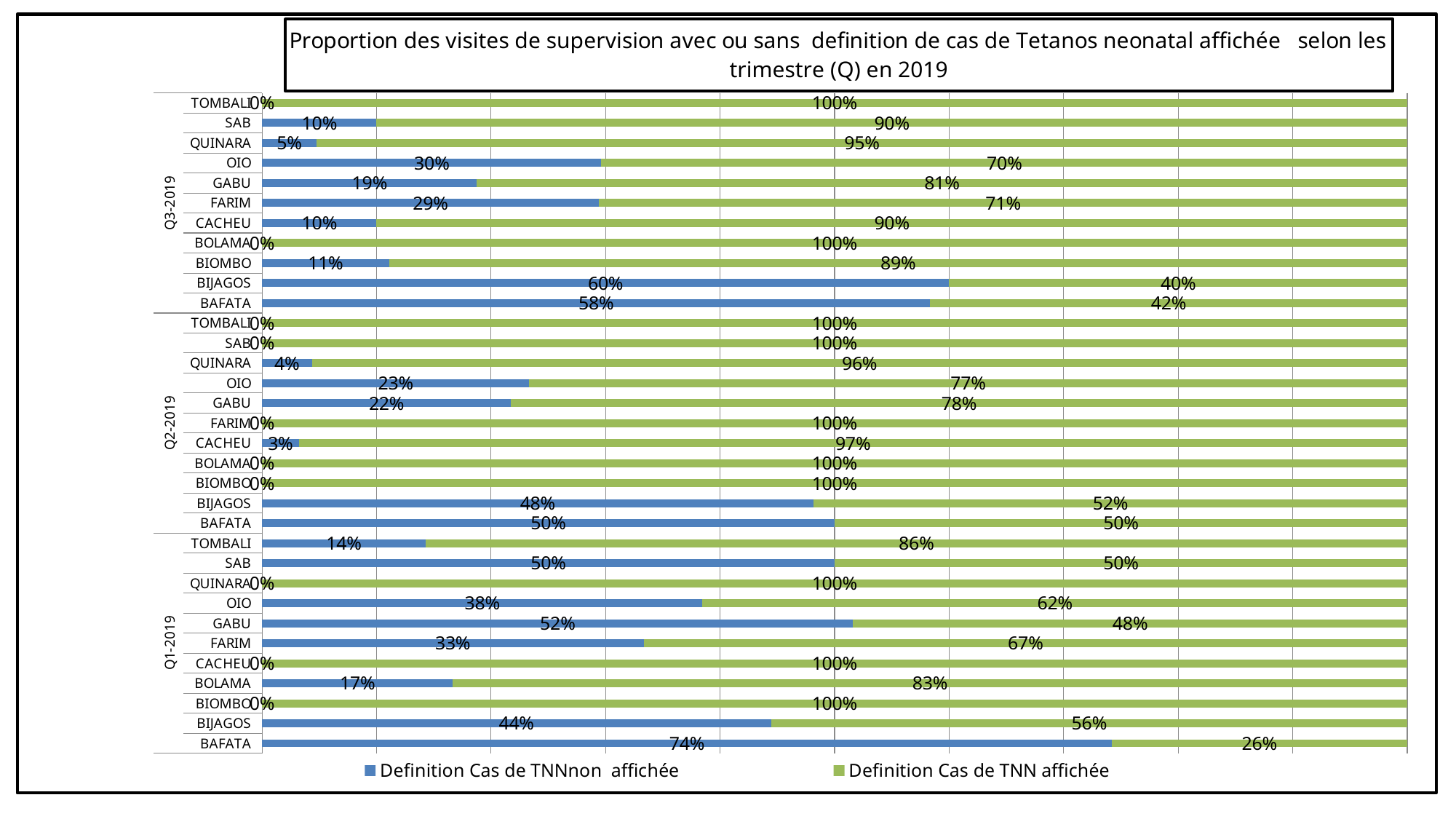
What is the value of 'Definition Cas de TNN affichée' for GABU in Q2-2019? 78% Within Q3-2019, which region has the lowest value for 'Definition Cas de TNN affichée'? BIJAGOS Within Q1-2019, which region has the highest value for 'Definition Cas de TNNnon affichée'? BAFATA How many series does the legend list? 2 What type of chart is shown on the slide? bar chart How many regions are listed under Q3-2019? 11 What is the value of 'Definition Cas de TNN affichée' for BIJAGOS in Q3-2019? 40% What is the value of 'Definition Cas de TNNnon affichée' for OIO in Q3-2019? 30% What colour represents the 'Definition Cas de TNN affichée' series? green In Q1-2019, which has the larger 'Definition Cas de TNNnon affichée' value: GABU or FARIM? GABU What is the value of 'Definition Cas de TNNnon affichée' for BAFATA in Q1-2019? 74% In Q1-2019, what is the difference between the 'affichée' and 'non affichée' values for OIO? 24%